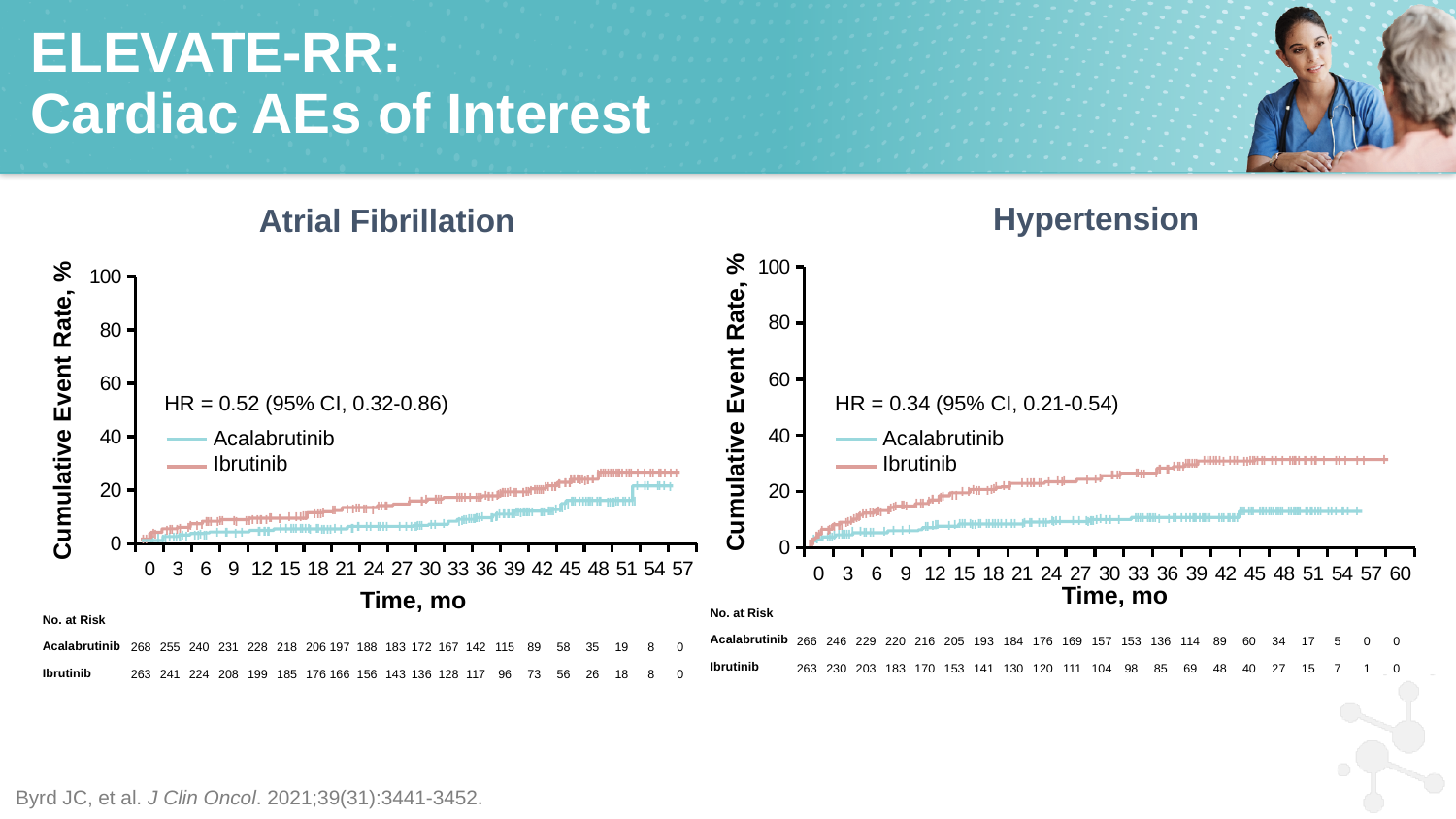
In the Hypertension chart, is the cumulative event rate for Acalabrutinib at 54 months greater or less than 20? less In the Atrial Fibrillation chart, do the cumulative event rate curves rise or fall as time increases? rise What hazard ratio is printed on the Hypertension chart? HR = 0.34 (95% CI, 0.21-0.54) What kind of chart is the Atrial Fibrillation chart? line chart In the Hypertension chart, is the cumulative event rate for Ibrutinib at 57 months greater or less than 20? greater In the Hypertension chart, which series has the higher cumulative event rate at 36 months, Acalabrutinib or Ibrutinib? Ibrutinib In the Atrial Fibrillation chart's No. at Risk table, how many Acalabrutinib patients are at risk at 0 months? 268 What hazard ratio is printed on the Atrial Fibrillation chart? HR = 0.52 (95% CI, 0.32-0.86) In the Hypertension chart's No. at Risk table, how many Ibrutinib patients are at risk at 0 months? 263 How many series does the legend of the Hypertension chart list? 2 In the Atrial Fibrillation chart, is the cumulative event rate for Acalabrutinib at 30 months greater or less than 20? less In the Atrial Fibrillation chart's No. at Risk table, what is the difference between the Acalabrutinib and Ibrutinib numbers at risk at 0 months? 5